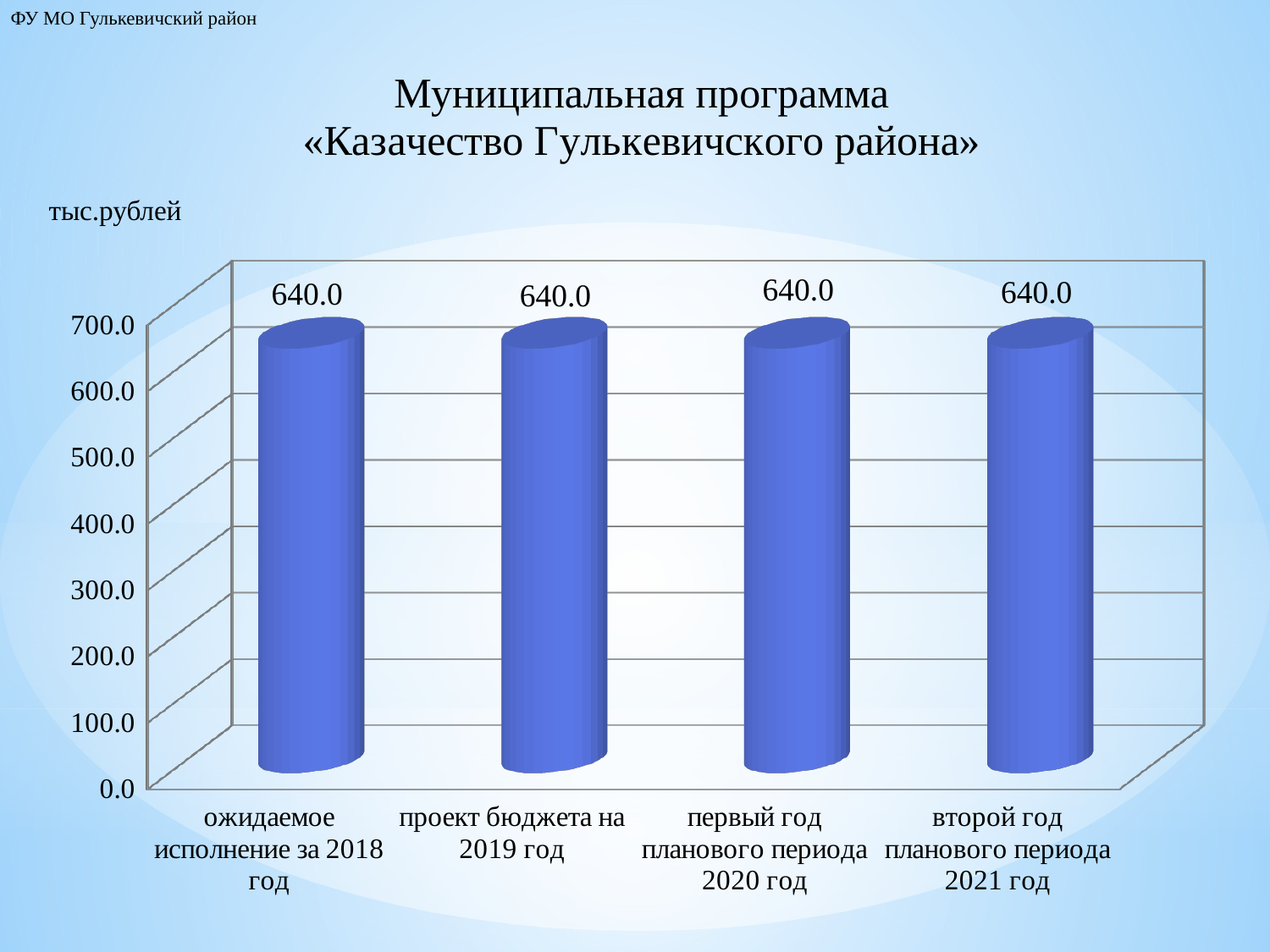
What is the title of the chart on the slide? Муниципальная программа «Казачество Гулькевичского района» What is the value for «первый год планового периода 2020 год»? 640.0 Do the values rise, fall or stay the same from 2018 год to 2021 год? stay the same How many categories are shown on the chart? 4 What is the difference between the value for 2019 год and the value for 2018 год? 0.0 What kind of chart is shown on the slide? bar chart What is the value for «проект бюджета на 2019 год»? 640.0 Is the value for «проект бюджета на 2019 год» greater or less than 600.0? greater What unit of measurement is indicated for the chart values? тыс.рублей What is the value for «второй год планового периода 2021 год»? 640.0 Is the value for «второй год планового периода 2021 год» greater or less than 700.0? less What is the value for «ожидаемое исполнение за 2018 год»? 640.0